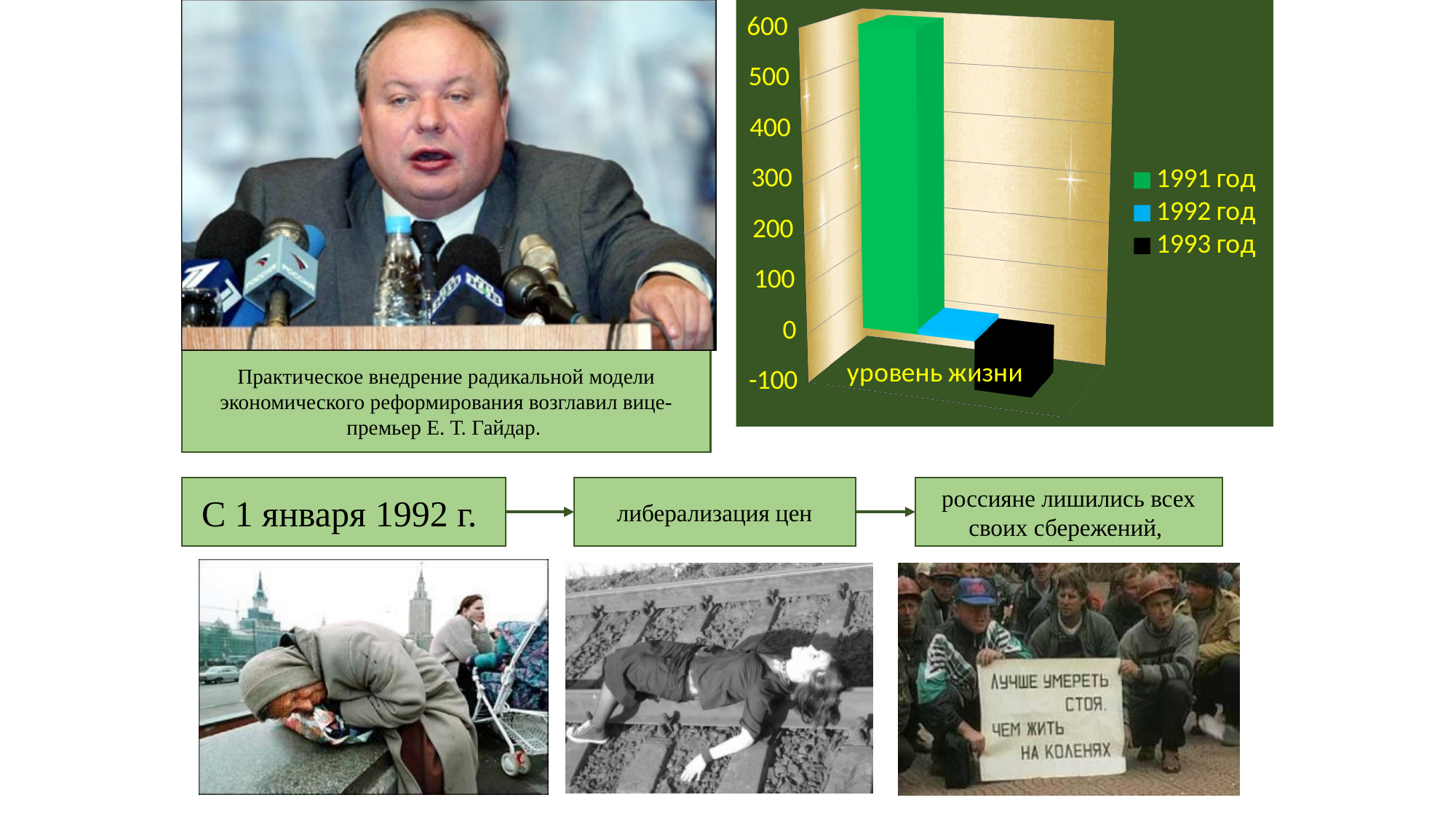
What kind of chart is shown on the slide? bar chart Which series has the lowest value for уровень жизни? 1993 год How many series does the chart legend list? 3 What colour represents the series 1993 год in the chart legend? black Which is larger for уровень жизни: the value for 1992 год or the value for 1993 год? 1992 год Which is larger for уровень жизни: the value for 1991 год or the value for 1992 год? 1991 год How many categories are plotted on the x axis of the chart? 1 Is the value for 1991 год greater or less than 500? greater What is the category label shown on the x axis of the chart? уровень жизни Which series has the highest value for уровень жизни? 1991 год Is the value for 1993 год greater or less than 0? less Is the value for 1992 год greater or less than 100? less